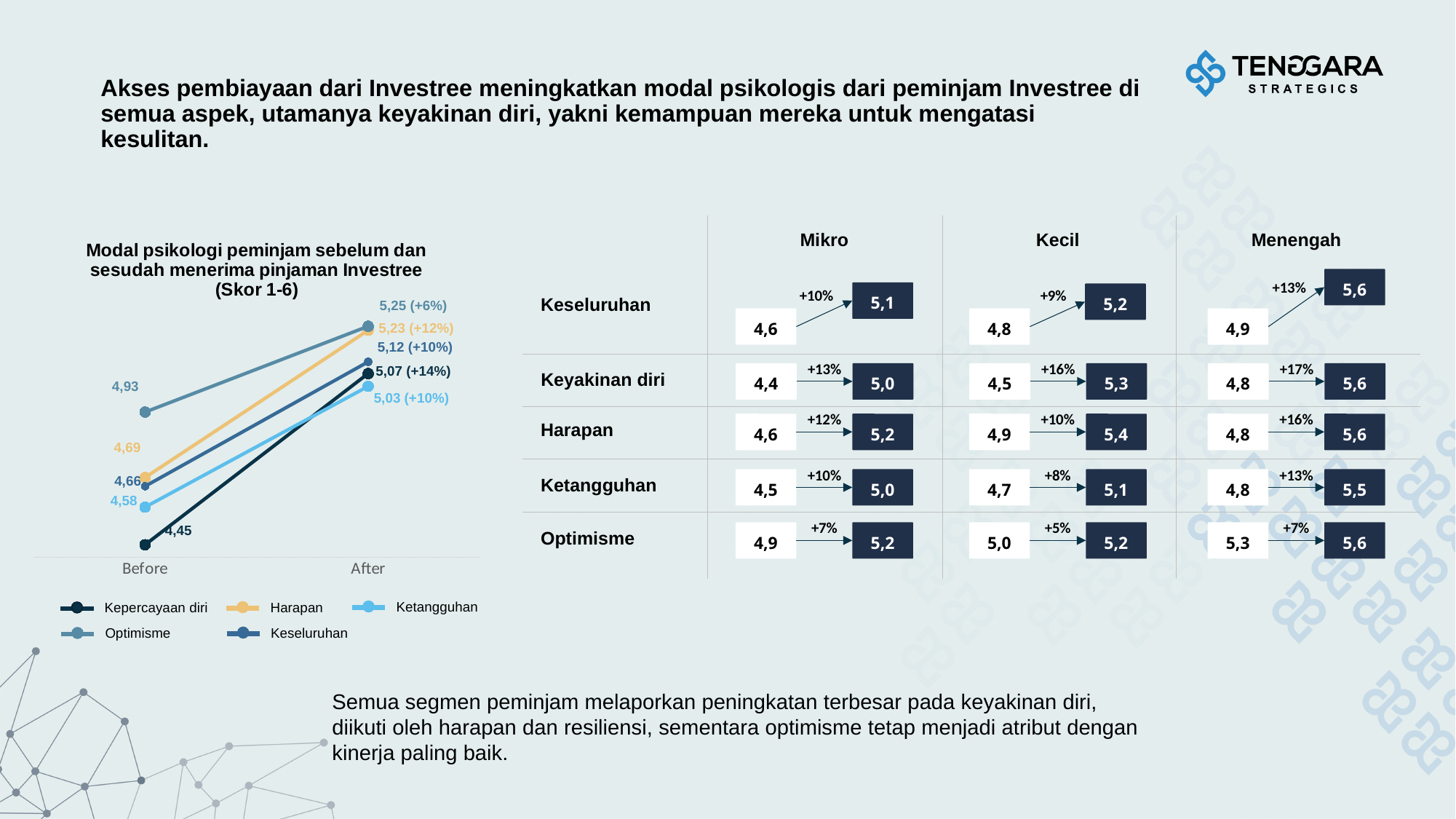
In the line chart, what is the Before value for Optimisme? 4,93 In the line chart, do the values rise or fall from Before to After? rise In the line chart, what is the After value for Harapan? 5,23 In the line chart, which has the larger After value, Harapan or Keseluruhan? Harapan In the line chart, what is the difference between the After and Before values for Optimisme? 0,32 What kind of chart is shown on the left of the slide? line chart In the line chart, which series has the lowest After value? Ketangguhan In the line chart, what percentage increase is shown next to the After value for Kepercayaan diri? +14% How many series does the legend of the line chart list? 5 In the line chart, what is the Before value for Kepercayaan diri? 4,45 In the line chart, which series has the highest Before value? Optimisme How many points are on the x axis of the line chart? 2